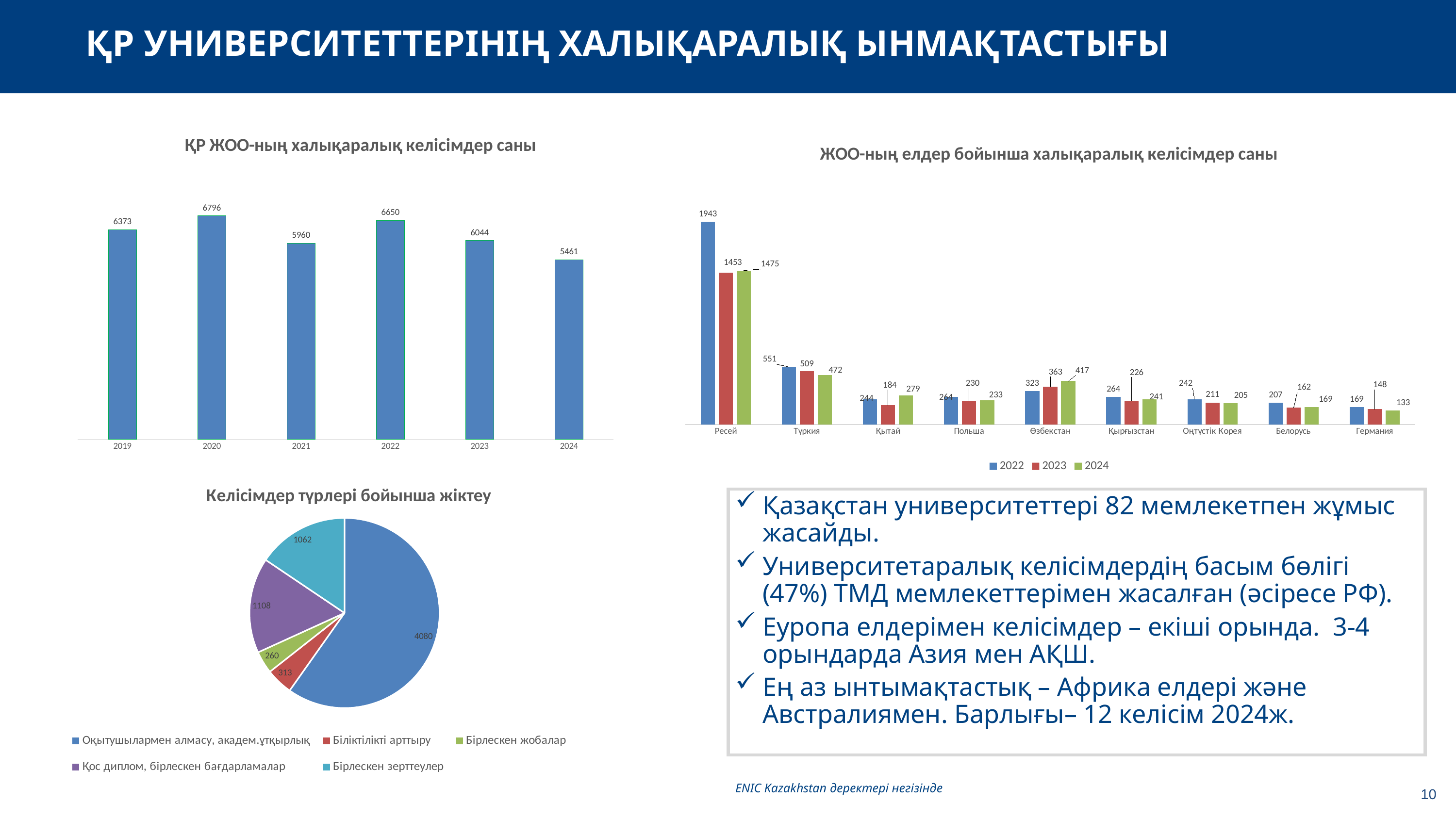
In the chart titled 'Келісімдер түрлері бойынша жіктеу', what is the value for 'Қос диплом, бірлескен бағдарламалар'? 1108 In the chart titled 'ЖОО-ның елдер бойынша халықаралық келісімдер саны', what is the 2022 value for Ресей? 1943 What kind of chart is 'Келісімдер түрлері бойынша жіктеу'? Pie chart In the chart titled 'ҚР ЖОО-ның халықаралық келісімдер саны', which year has the lowest value? 2024 In the chart titled 'ЖОО-ның елдер бойынша халықаралық келісімдер саны', what is the 2024 value for Өзбекстан? 417 In the chart titled 'ЖОО-ның елдер бойынша халықаралық келісімдер саны', how many countries are shown on the x axis? 9 In the chart titled 'Келісімдер түрлері бойынша жіктеу', which category has the largest slice? Оқытушылармен алмасу, академ.ұтқырлық In the chart titled 'ҚР ЖОО-ның халықаралық келісімдер саны', what is the value for 2020? 6796 In the chart titled 'ҚР ЖОО-ның халықаралық келісімдер саны', how many years are shown on the x axis? 6 In the chart titled 'ЖОО-ның елдер бойынша халықаралық келісімдер саны', how many series does the legend list? 3 In the chart titled 'ЖОО-ның елдер бойынша халықаралық келісімдер саны', which is larger for Түркия: the 2022 value or the 2024 value? 2022 In the chart titled 'ҚР ЖОО-ның халықаралық келісімдер саны', what is the difference between the values for 2019 and 2024? 912